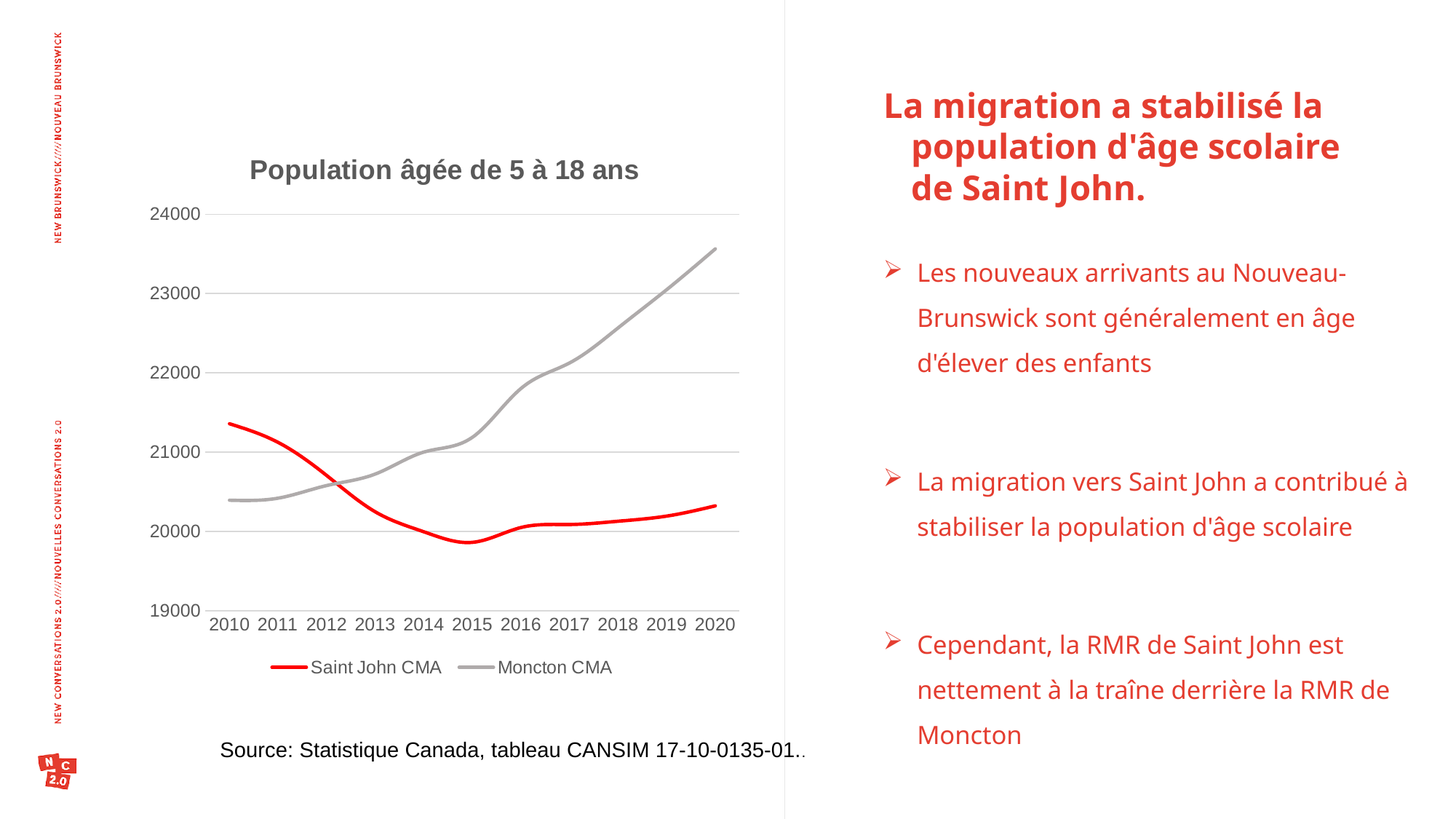
What kind of chart is shown on the slide? line chart Which series is drawn in red? Saint John CMA In which year does the Saint John CMA series reach its lowest value? 2015 Is the value for Moncton CMA in 2020 greater or less than 23000? greater Is the value for Saint John CMA in 2010 greater or less than 21000? greater Is the value for Moncton CMA in 2010 greater or less than 21000? less In 2020, which series has the higher value, Saint John CMA or Moncton CMA? Moncton CMA How many years are plotted along the x axis? 11 How many series does the legend list? 2 What is the title of the chart? Population âgée de 5 à 18 ans In 2010, which series has the higher value, Saint John CMA or Moncton CMA? Saint John CMA